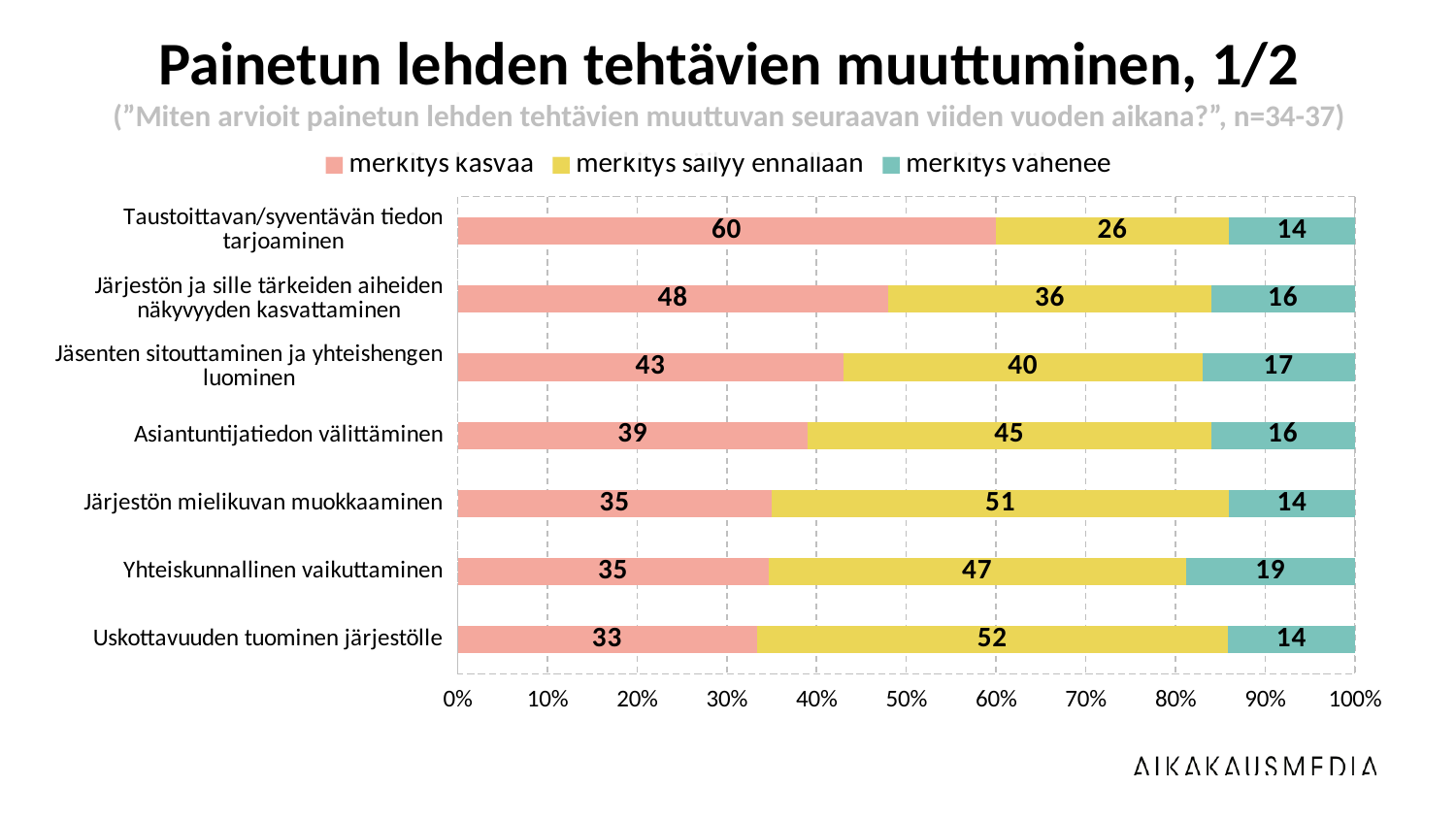
How many categories are shown on the chart? 7 What is the difference between the "merkitys kasvaa" values for "Taustoittavan/syventävän tiedon tarjoaminen" and "Järjestön ja sille tärkeiden aiheiden näkyvyyden kasvattaminen"? 12 What is the value of "merkitys vähenee" for "Yhteiskunnallinen vaikuttaminen"? 19 How many series does the legend list? 3 What kind of chart is shown on the slide? Stacked bar chart What is the value of "merkitys kasvaa" for "Taustoittavan/syventävän tiedon tarjoaminen"? 60 What is the value of "merkitys säilyy ennallaan" for "Uskottavuuden tuominen järjestölle"? 52 Which category has the highest value for "merkitys kasvaa"? Taustoittavan/syventävän tiedon tarjoaminen Which category has the lowest value for "merkitys kasvaa"? Uskottavuuden tuominen järjestölle Which is larger for "Asiantuntijatiedon välittäminen": "merkitys kasvaa" or "merkitys säilyy ennallaan"? merkitys säilyy ennallaan What is the total of the stacked bar for "Jäsenten sitouttaminen ja yhteishengen luominen"? 100 Which category has the highest value for "merkitys vähenee"? Yhteiskunnallinen vaikuttaminen